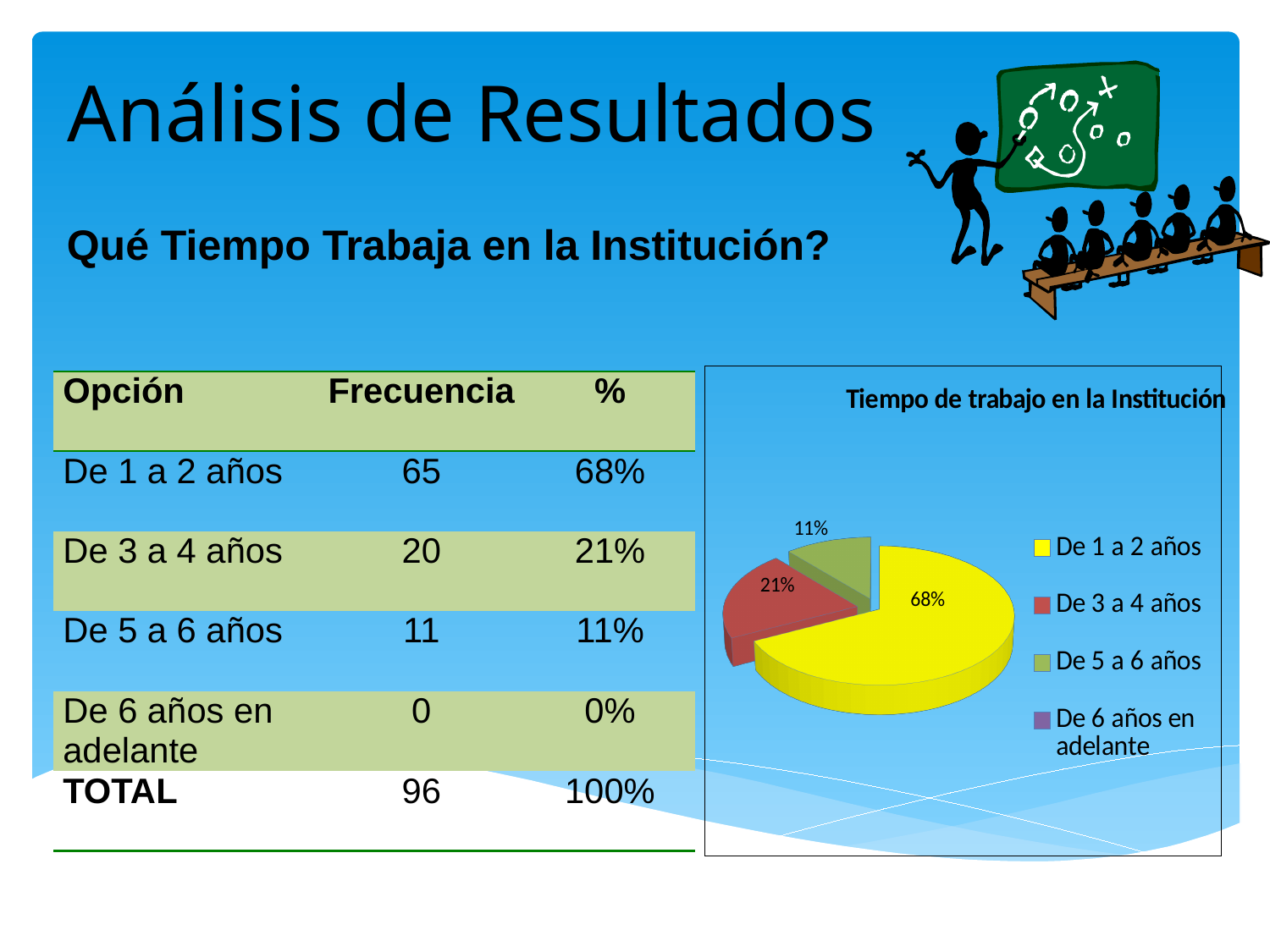
Which category has the largest slice of the pie? De 1 a 2 años What is the difference in percentage points between the 'De 1 a 2 años' slice and the 'De 3 a 4 años' slice? 47% What is the difference in percentage points between the 'De 3 a 4 años' slice and the 'De 5 a 6 años' slice? 10% What kind of chart is shown on the slide? pie chart What share of the pie does 'De 3 a 4 años' represent? 21% What share of the pie does 'De 1 a 2 años' represent? 68% Which category with a visible slice has the smallest share of the pie? De 5 a 6 años How many entries does the legend list? 4 What share of the pie does 'De 5 a 6 años' represent? 11% What is the title of the chart? Tiempo de trabajo en la Institución Which slice is larger, 'De 3 a 4 años' or 'De 5 a 6 años'? De 3 a 4 años What colour is the slice for 'De 1 a 2 años'? yellow